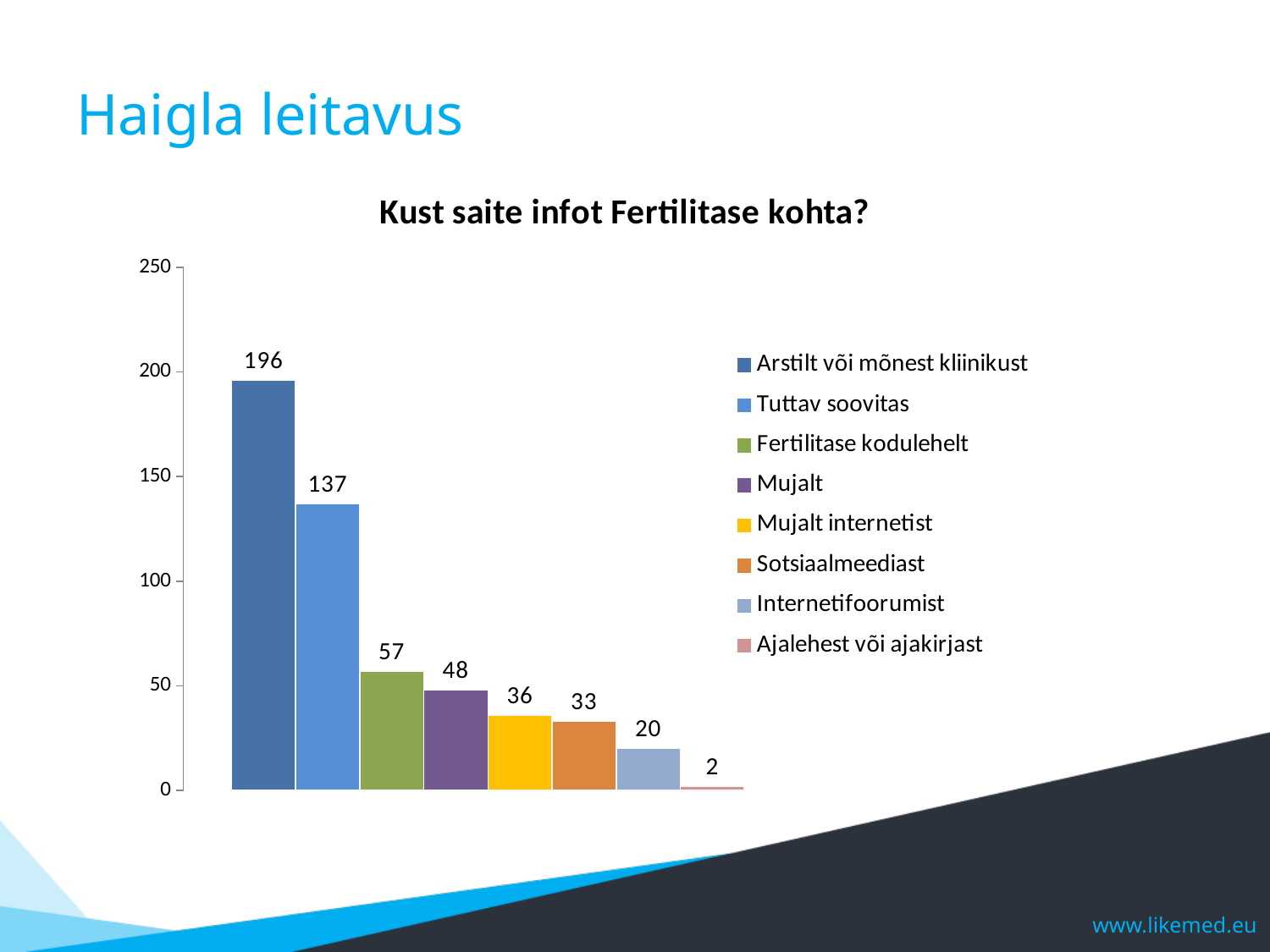
Which source has the highest value? Arstilt või mõnest kliinikust Which is larger, "Mujalt" or "Mujalt internetist"? Mujalt What is the value for "Tuttav soovitas"? 137 What is the title of the chart? Kust saite infot Fertilitase kohta? What is the value for "Sotsiaalmeediast"? 33 What is the value for "Fertilitase kodulehelt"? 57 What is the difference between "Arstilt või mõnest kliinikust" and "Tuttav soovitas"? 59 Is the value for "Tuttav soovitas" greater or less than 150? less How many sources are shown in the chart? 8 What kind of chart is shown? Bar chart What is the value for "Arstilt või mõnest kliinikust"? 196 Which source has the lowest value? Ajalehest või ajakirjast